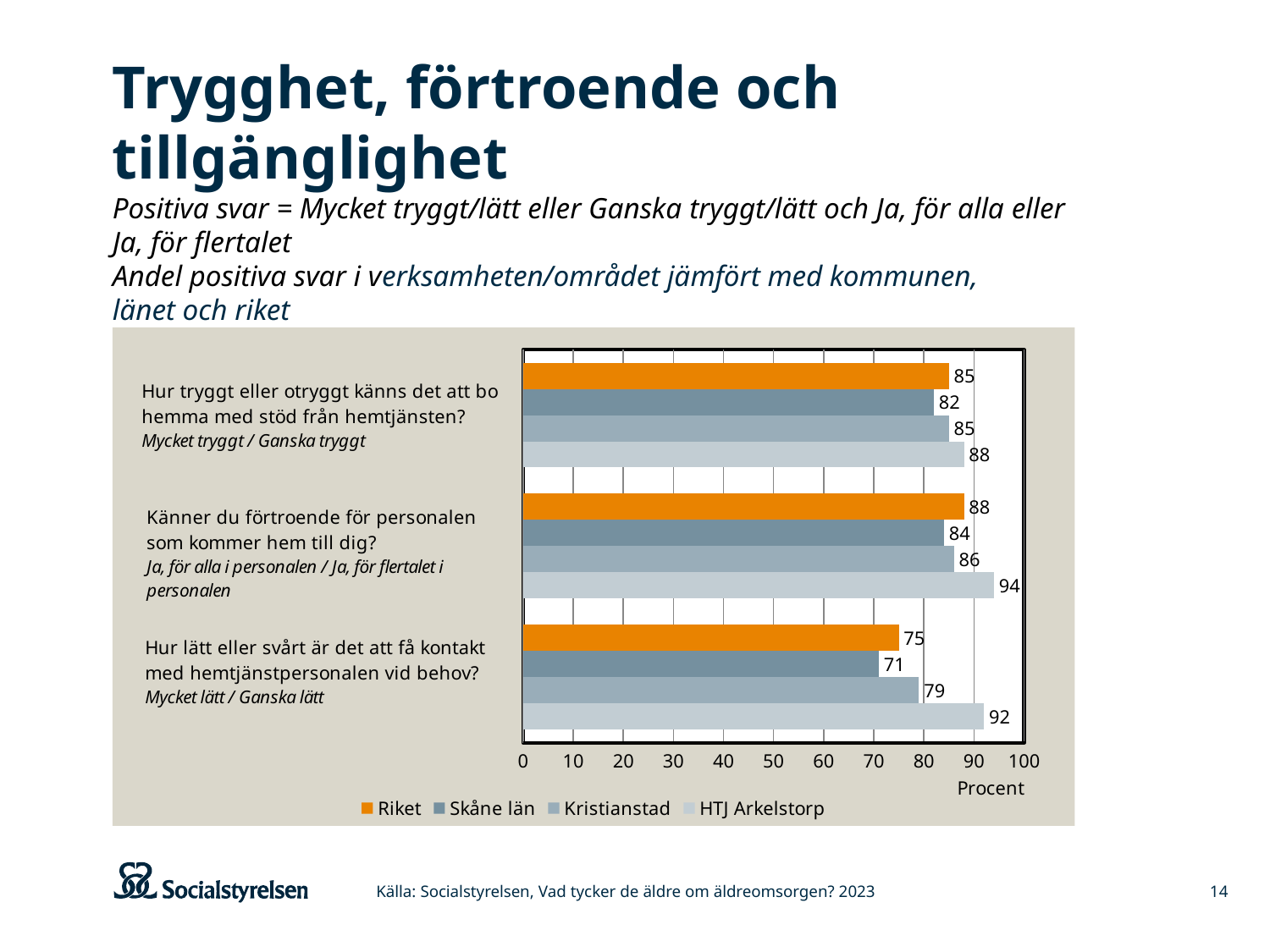
What is the value for HTJ Arkelstorp on the question "Känner du förtroende för personalen som kommer hem till dig?"? 94 How many question categories are shown on the chart? 3 What is the value for Skåne län on the question "Hur lätt eller svårt är det att få kontakt med hemtjänstpersonalen vid behov?"? 71 What is the label on the horizontal axis of the chart? Procent Which series has the lowest value on the question "Hur lätt eller svårt är det att få kontakt med hemtjänstpersonalen vid behov?"? Skåne län How many series does the legend list? 4 What kind of chart is shown on the slide? bar chart What is the difference between HTJ Arkelstorp and Riket on the question "Hur lätt eller svårt är det att få kontakt med hemtjänstpersonalen vid behov?"? 17 What is the value for Riket on the question "Hur tryggt eller otryggt känns det att bo hemma med stöd från hemtjänsten?"? 85 Which is larger on the question "Känner du förtroende för personalen som kommer hem till dig?": Riket or Kristianstad? Riket What is the difference between HTJ Arkelstorp and Skåne län on the question "Hur tryggt eller otryggt känns det att bo hemma med stöd från hemtjänsten?"? 6 Which series has the highest value on the question "Känner du förtroende för personalen som kommer hem till dig?"? HTJ Arkelstorp